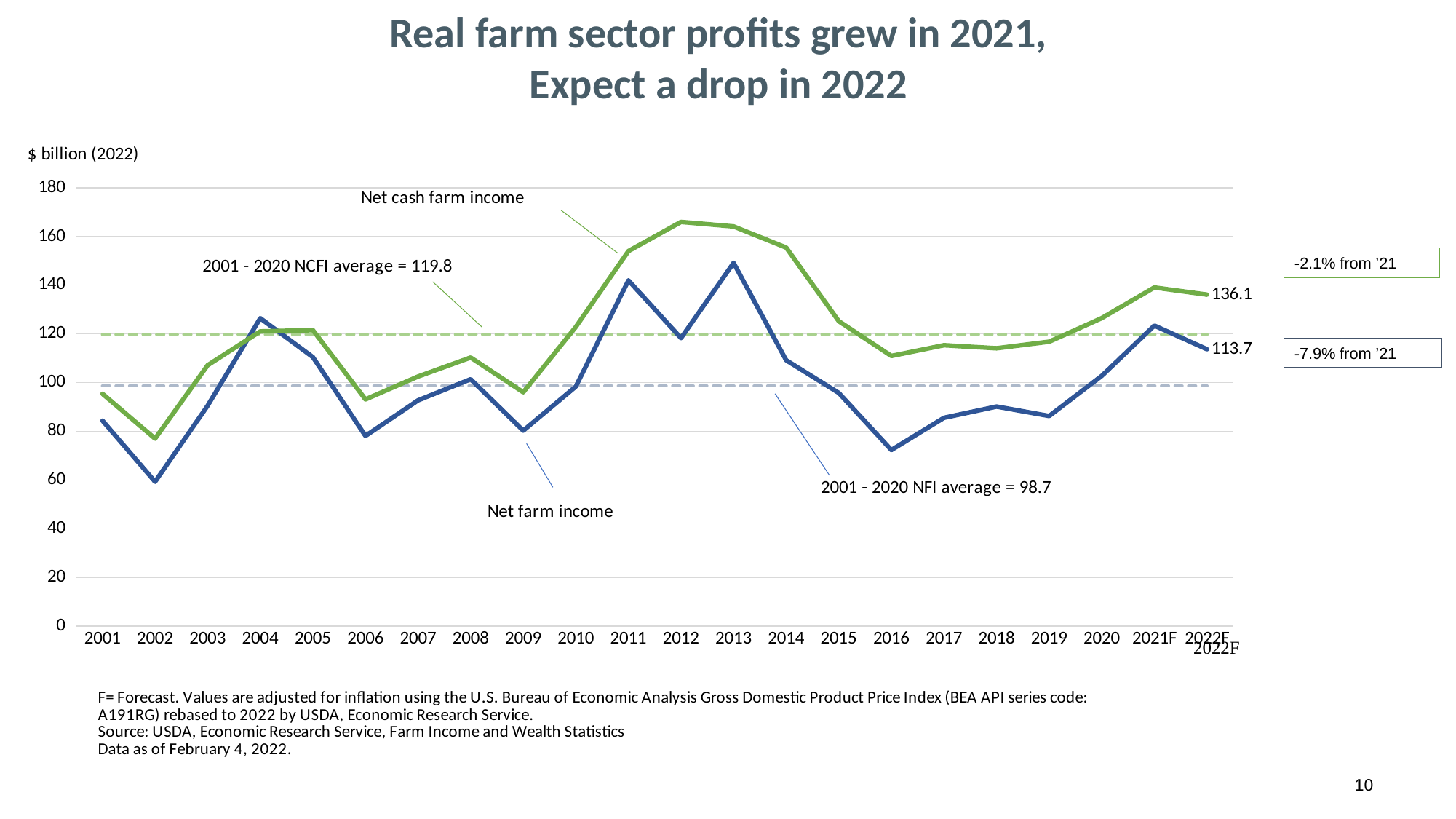
What is the value of Net cash farm income for 2022F? 136.1 Is the value of Net cash farm income in 2012 greater or less than 160? greater What is the difference between Net cash farm income and Net farm income in 2022F? 22.4 What is the value of Net farm income for 2022F? 113.7 What is the 2001 - 2020 NFI average shown on the chart? 98.7 In which year is Net farm income at its lowest? 2002 Is the value of Net farm income in 2016 greater or less than 80? less How many years are shown on the x axis of the chart? 22 What percentage change from 2021 is annotated for Net farm income in 2022F? -7.9% from '21 What kind of chart is shown on the slide? line chart In which year is Net farm income at its highest? 2013 What is the 2001 - 2020 NCFI average shown on the chart? 119.8